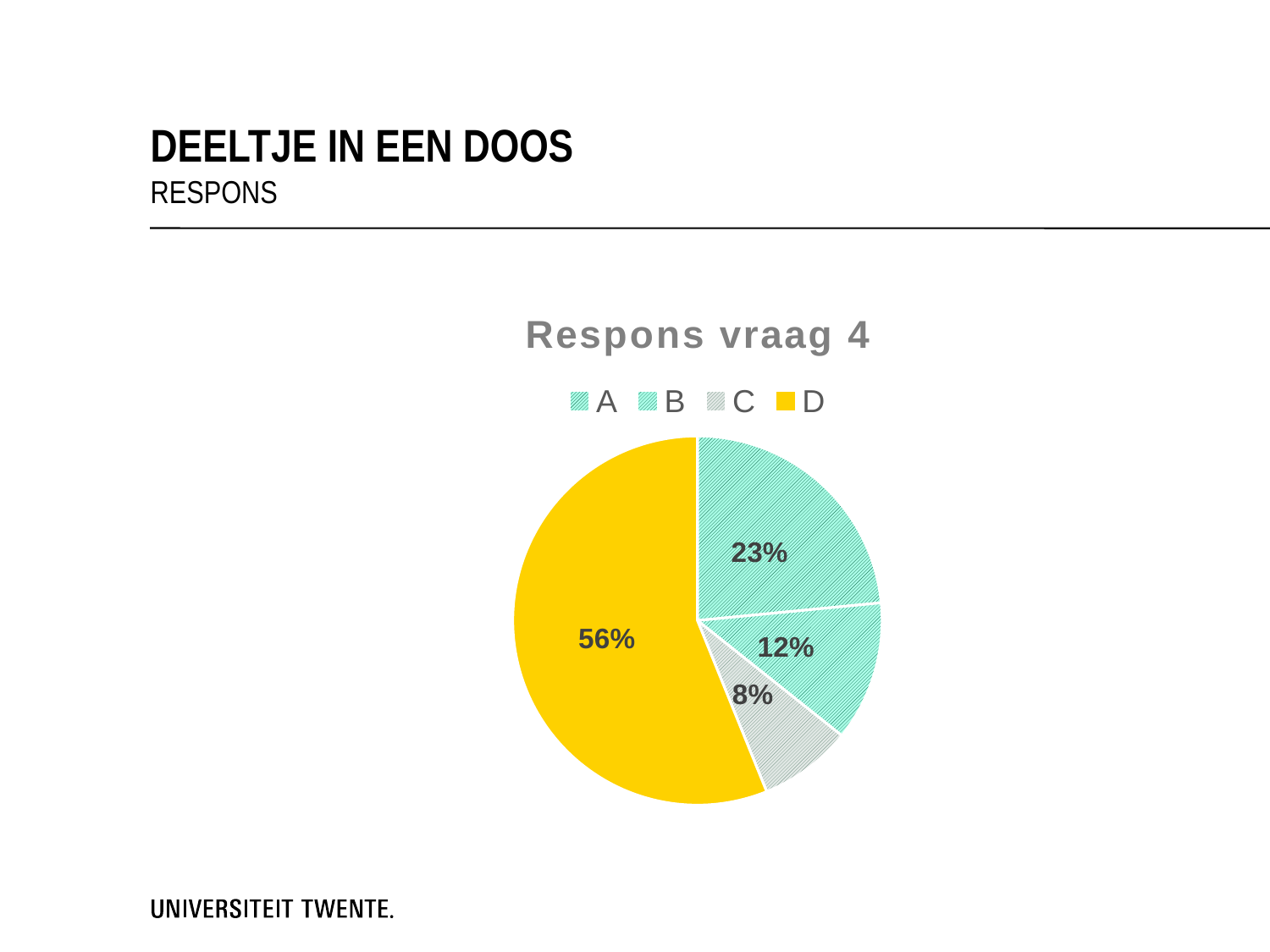
Which is larger, the slice for A or the slice for B? A What is the title of the chart? Respons vraag 4 How many categories does the legend list? 4 What percentage of the pie does category C take? 8% Which category has the smallest slice of the pie? C Which category is shown in solid yellow? D What percentage of the pie does category A take? 23% What is the difference in percentage points between category D and category A? 33 Which category has the largest slice of the pie? D What kind of chart is shown on the slide? pie chart What percentage of the pie does category D take? 56% What percentage of the pie does category B take? 12%